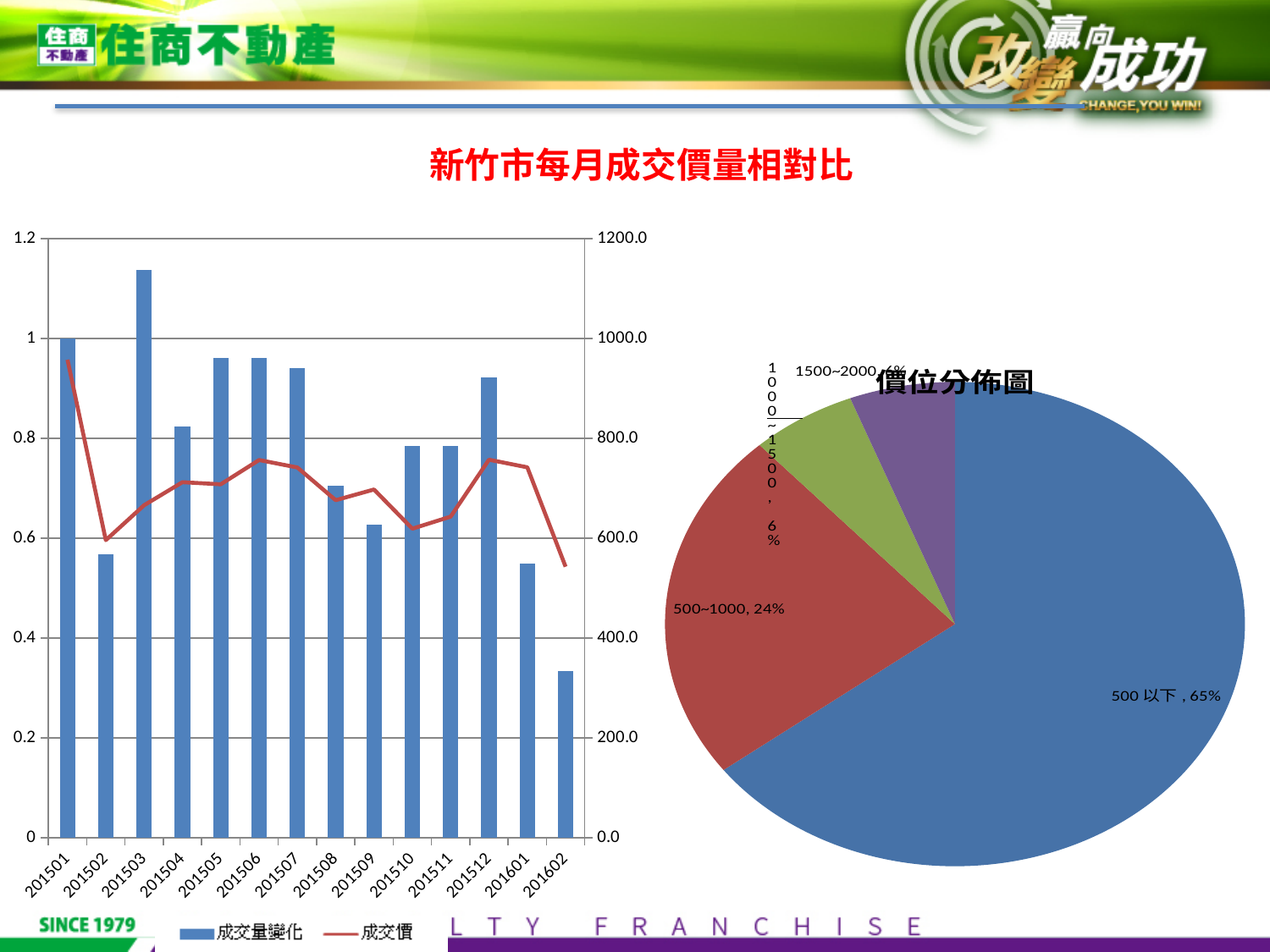
In the pie chart 價位分佈圖, what share does the 500~1000 slice have? 24% In the left chart, how many series does the legend list? 2 In the left chart, how many months are shown on the x axis? 14 In the left chart, which month has the highest 成交量變化 bar? 201503 What kind of chart is the chart on the right of the slide (價位分佈圖)? pie chart In the left chart, which is larger, the 成交量變化 bar for 201503 or for 201501? 201503 How many slices does the pie chart 價位分佈圖 have? 4 In the left chart, which month has the lowest 成交量變化 bar? 201602 In the pie chart 價位分佈圖, what share does the 500 以下 slice have? 65% In the left chart, is the 成交量變化 bar for 201602 greater or less than 0.4? less In the pie chart 價位分佈圖, which slice is the largest? 500 以下 In the left chart, is the 成交價 line value for 201501 greater or less than 800.0? greater